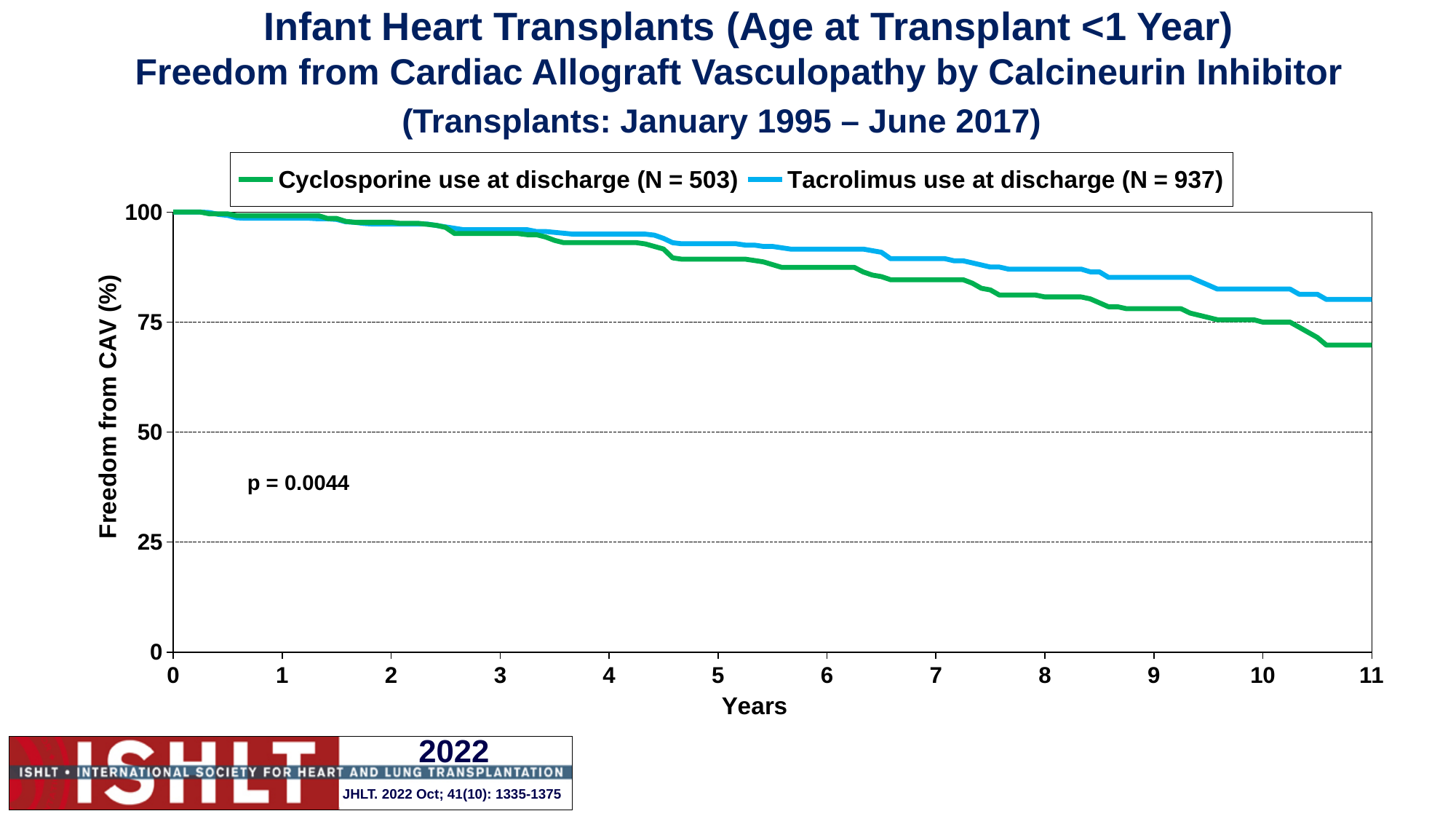
Is the value for Cyclosporine use at discharge at year 11 greater or less than 75? less What p-value is shown on the chart? p = 0.0044 How many series does the legend list? 2 At year 11, which group has the higher freedom from CAV, Cyclosporine use at discharge or Tacrolimus use at discharge? Tacrolimus use at discharge What is the N for the Tacrolimus use at discharge group in the legend? 937 Do the values for Cyclosporine use at discharge rise or fall as years increase? fall Is the value for Tacrolimus use at discharge at year 11 greater or less than 75? greater Is the value for Cyclosporine use at discharge at year 5 greater or less than 75? greater What is the freedom from CAV for the Cyclosporine use at discharge group at year 0? 100 What kind of chart is shown on the slide? line chart Do the values for Tacrolimus use at discharge rise or fall as years increase? fall